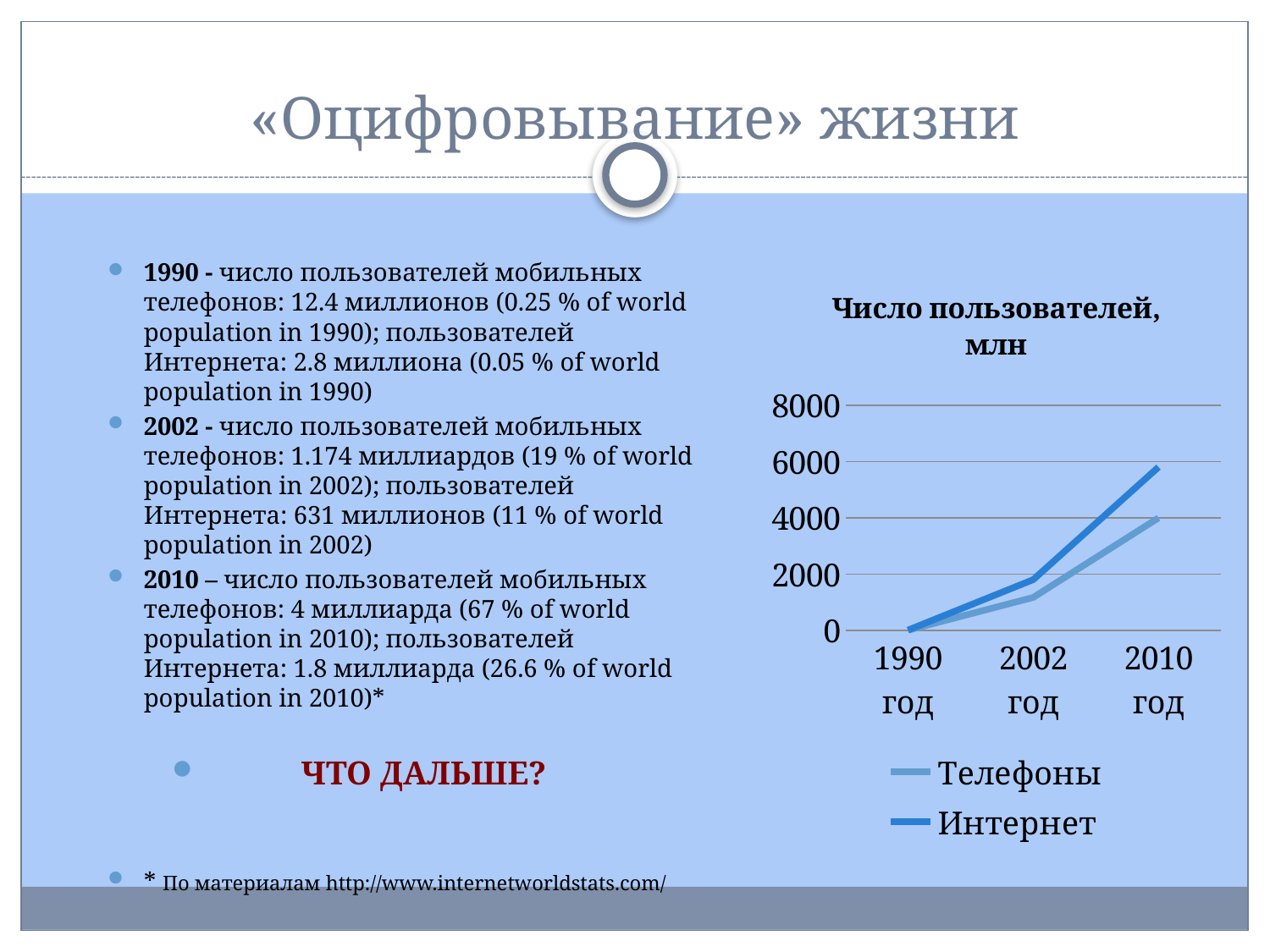
Is the value of the Телефоны series at 2010 год greater or less than 2000? greater In which year does the Интернет series reach its highest value? 2010 год Do the values of the Телефоны series rise or fall from 1990 год to 2010 год? rise Which two series are listed in the chart legend? Телефоны and Интернет What is the title of the chart? Число пользователей, млн What kind of chart is shown on the slide? line chart Is the value of the Телефоны series at 2002 год greater or less than 2000? less Do the values of the Интернет series rise or fall from 1990 год to 2010 год? rise How many years are plotted along the x axis of the chart? 3 How many series does the chart legend list? 2